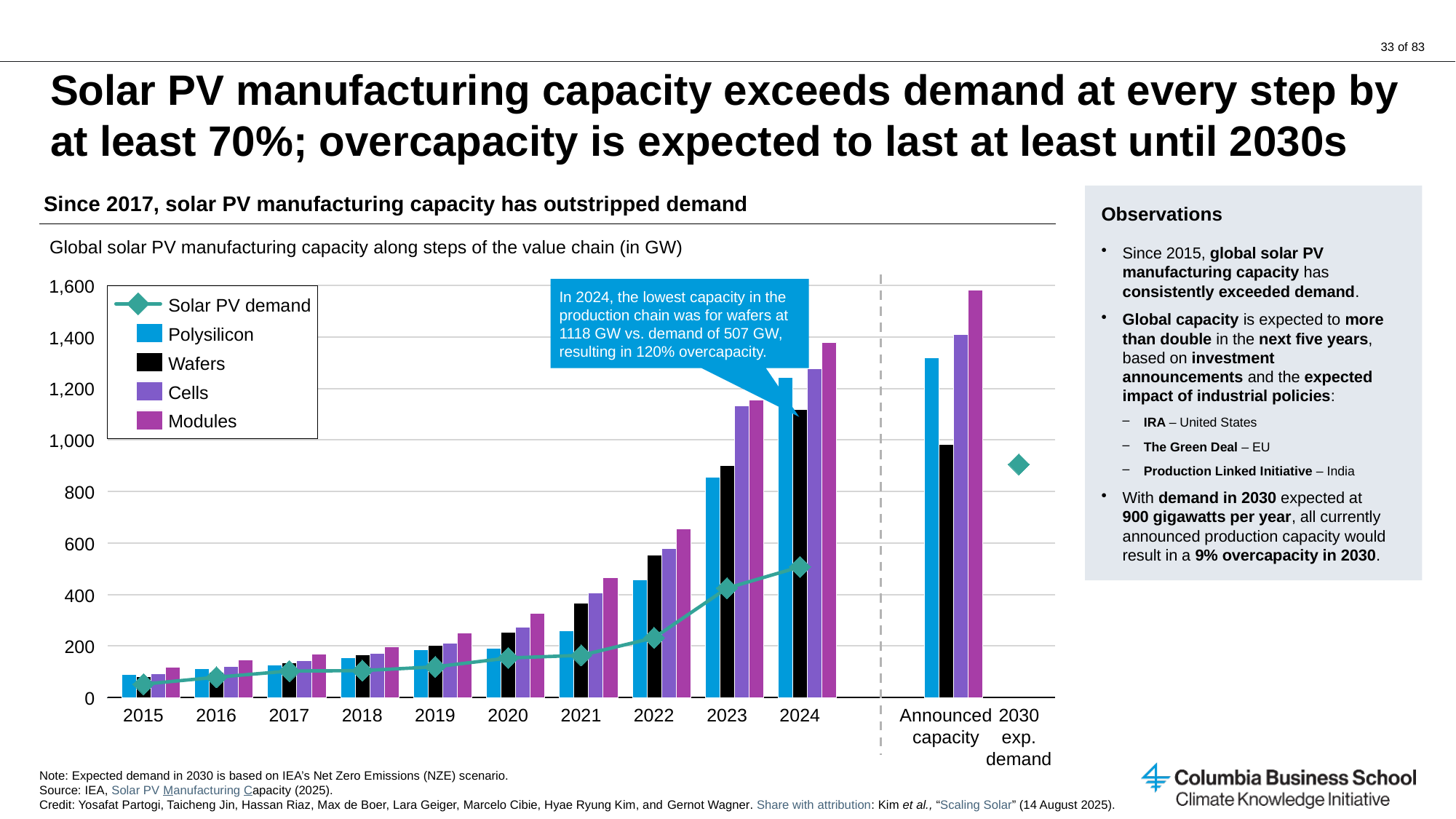
According to the callout, what was the wafer manufacturing capacity in 2024? 1118 GW Which value chain step has the highest capacity in 2024? Modules What kind of chart is shown on the slide? combination bar and line chart Is the Modules capacity in 2024 greater or less than 1,200 GW? greater Which year has the lowest Modules capacity? 2015 How many years from 2015 onward are shown on the x axis before the dashed divider? 10 Is the Polysilicon capacity in 2015 greater or less than 200 GW? less How many entries does the chart legend list? 5 What is the difference between wafer capacity and solar PV demand in 2024, using the values in the callout? 611 GW According to the callout, what was solar PV demand in 2024? 507 GW Is the Modules value for Announced capacity greater or less than 1,400 GW? greater Does solar PV demand rise or fall from 2015 to 2024? rise